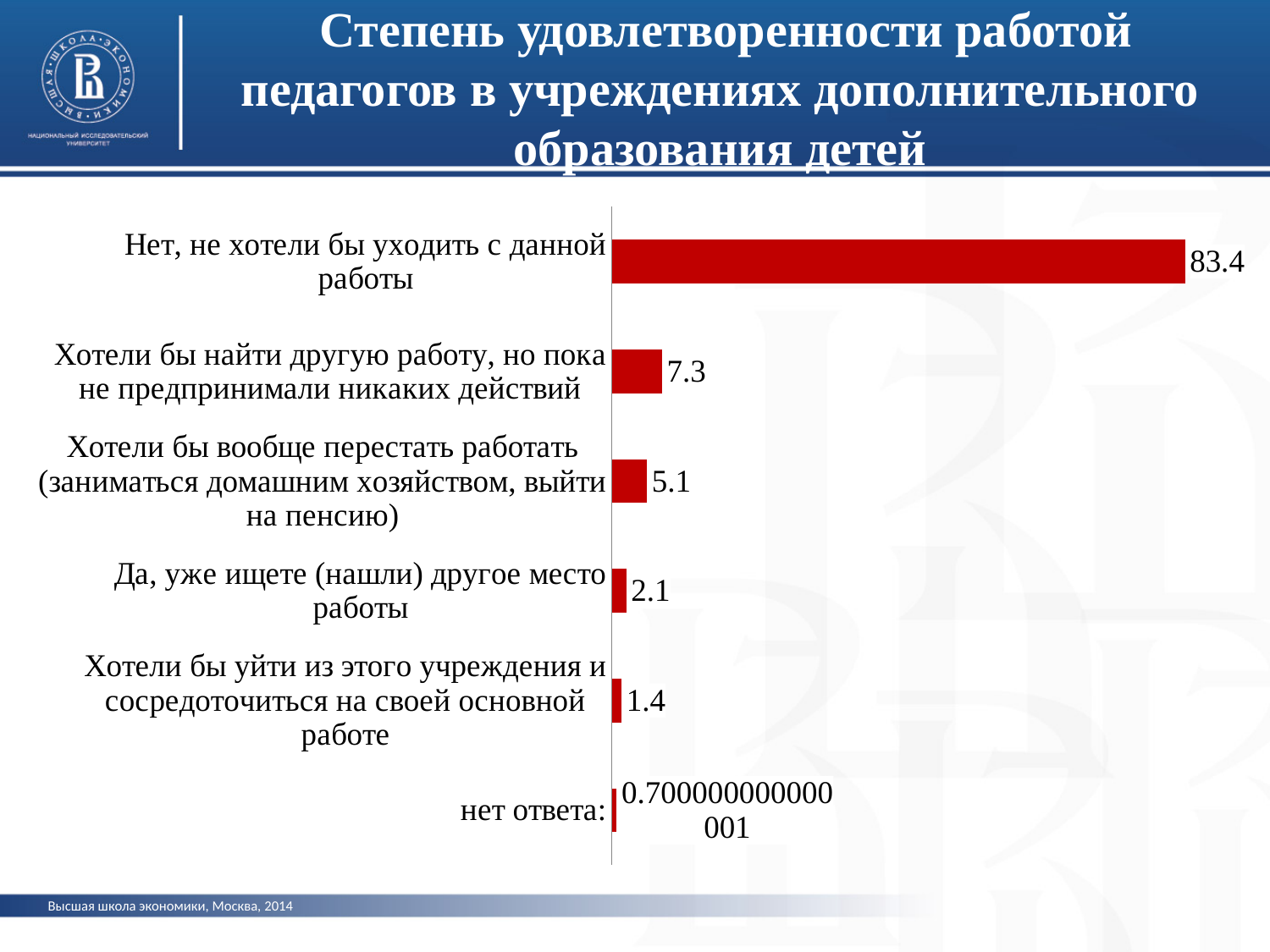
What is the value for "Хотели бы уйти из этого учреждения и сосредоточиться на своей основной работе"? 1.4 What is the value for "Хотели бы вообще перестать работать (заниматься домашним хозяйством, выйти на пенсию)"? 5.1 What is the difference between the values for "Хотели бы вообще перестать работать (заниматься домашним хозяйством, выйти на пенсию)" and "Да, уже ищете (нашли) другое место работы"? 3.0 Which category has the lowest value? нет ответа What is the difference between the values for "Нет, не хотели бы уходить с данной работы" and "Хотели бы найти другую работу, но пока не предпринимали никаких действий"? 76.1 Which is larger: the value for "Хотели бы найти другую работу, но пока не предпринимали никаких действий" or for "Хотели бы вообще перестать работать (заниматься домашним хозяйством, выйти на пенсию)"? Хотели бы найти другую работу, но пока не предпринимали никаких действий What is the value for "Да, уже ищете (нашли) другое место работы"? 2.1 What is the value for "Хотели бы найти другую работу, но пока не предпринимали никаких действий"? 7.3 How many categories are shown in the chart? 6 What is the value for "Нет, не хотели бы уходить с данной работы"? 83.4 What kind of chart is shown on the slide? Bar chart Which category has the highest value? Нет, не хотели бы уходить с данной работы